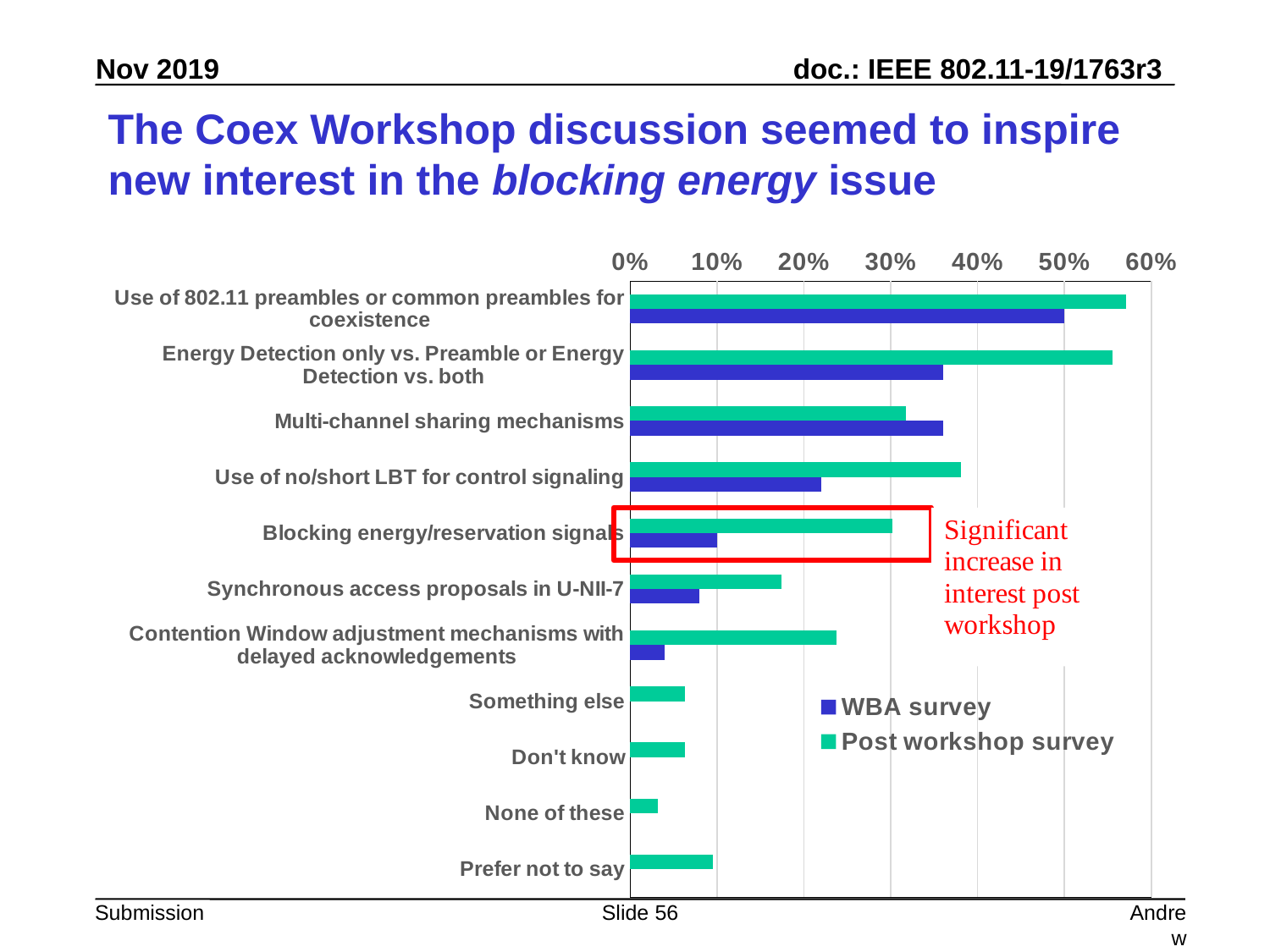
What kind of chart is shown on the slide? Bar chart Which category is highlighted with a red box on the chart? Blocking energy/reservation signals Which category has the highest value in the WBA survey series? Use of 802.11 preambles or common preambles for coexistence Is the WBA survey value for Contention Window adjustment mechanisms with delayed acknowledgements greater or less than 10%? less For Blocking energy/reservation signals, which series has the larger value, WBA survey or Post workshop survey? Post workshop survey How many categories are plotted on the chart? 11 Which colour represents the Post workshop survey series in the legend? Green Which category has the lowest non-zero value in the Post workshop survey series? None of these Which category has the highest value in the Post workshop survey series? Use of 802.11 preambles or common preambles for coexistence Is the Post workshop survey value for Energy Detection only vs. Preamble or Energy Detection vs. both greater or less than 50%? greater For Multi-channel sharing mechanisms, which series has the larger value, WBA survey or Post workshop survey? WBA survey How many series does the legend list? 2